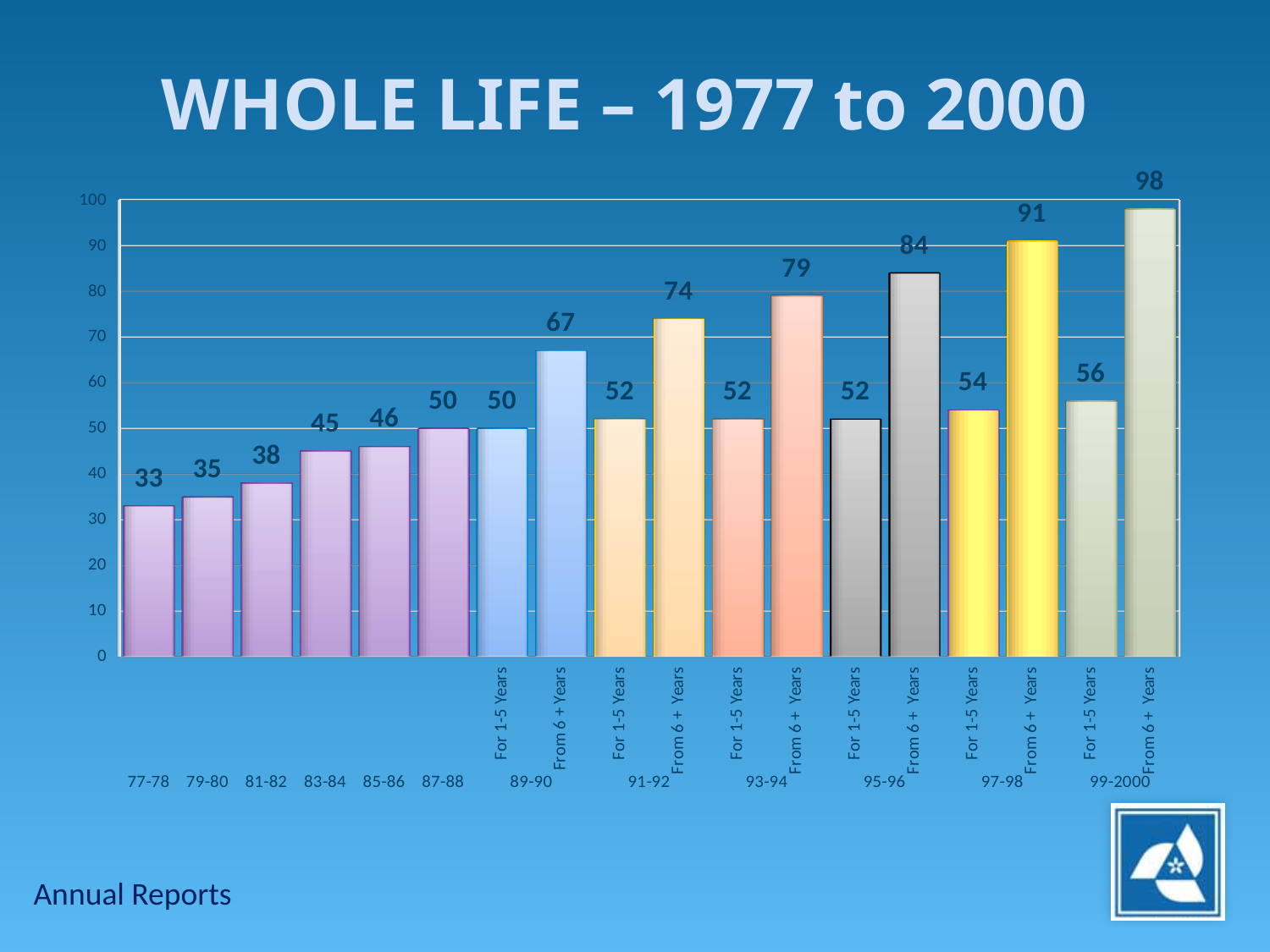
What is the value for 'For 1-5 Years' in 97-98? 54 Which bar has the highest value? From 6 + Years, 99-2000 Do the 'From 6 + Years' values rise or fall from 89-90 to 99-2000? Rise What is the value for 'From 6 + Years' in 99-2000? 98 What is the difference between the 'From 6 + Years' and 'For 1-5 Years' values in 95-96? 32 Which is larger: the value for 83-84 or the value for 'For 1-5 Years' in 91-92? For 1-5 Years in 91-92 What is the title of the chart? WHOLE LIFE – 1977 to 2000 What is the value for 77-78? 33 Which bar has the lowest value? 77-78 How many bars are plotted on the chart? 18 What kind of chart is shown on the slide? Bar chart What is the value for 'From 6 + Years' in 89-90? 67